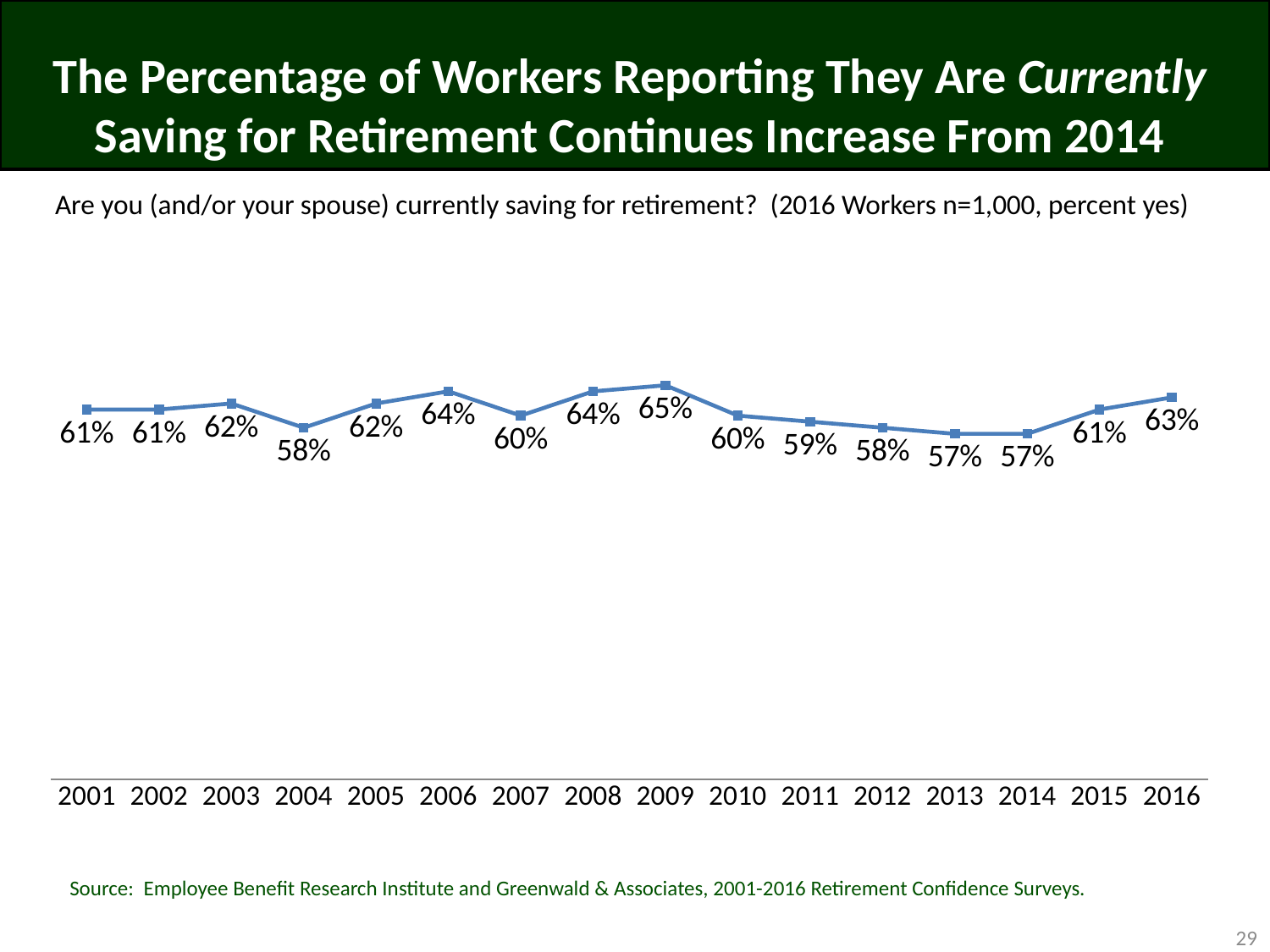
What is the difference between the 2009 value and the 2013 value? 8 percentage points What kind of chart is shown on the slide? Line chart Which year has the larger value, 2006 or 2007? 2006 What percentage of workers reported currently saving for retirement in 2016? 63% Which year has the larger value, 2003 or 2004? 2003 What is the difference between the 2016 value and the 2014 value? 6 percentage points How many years are plotted on the chart? 16 Do the values rise or fall from 2014 to 2016? Rise Which year has the highest percentage of workers currently saving for retirement? 2009 What is the lowest value shown on the chart? 57% What value is shown for 2004? 58% What value is shown for 2009? 65%